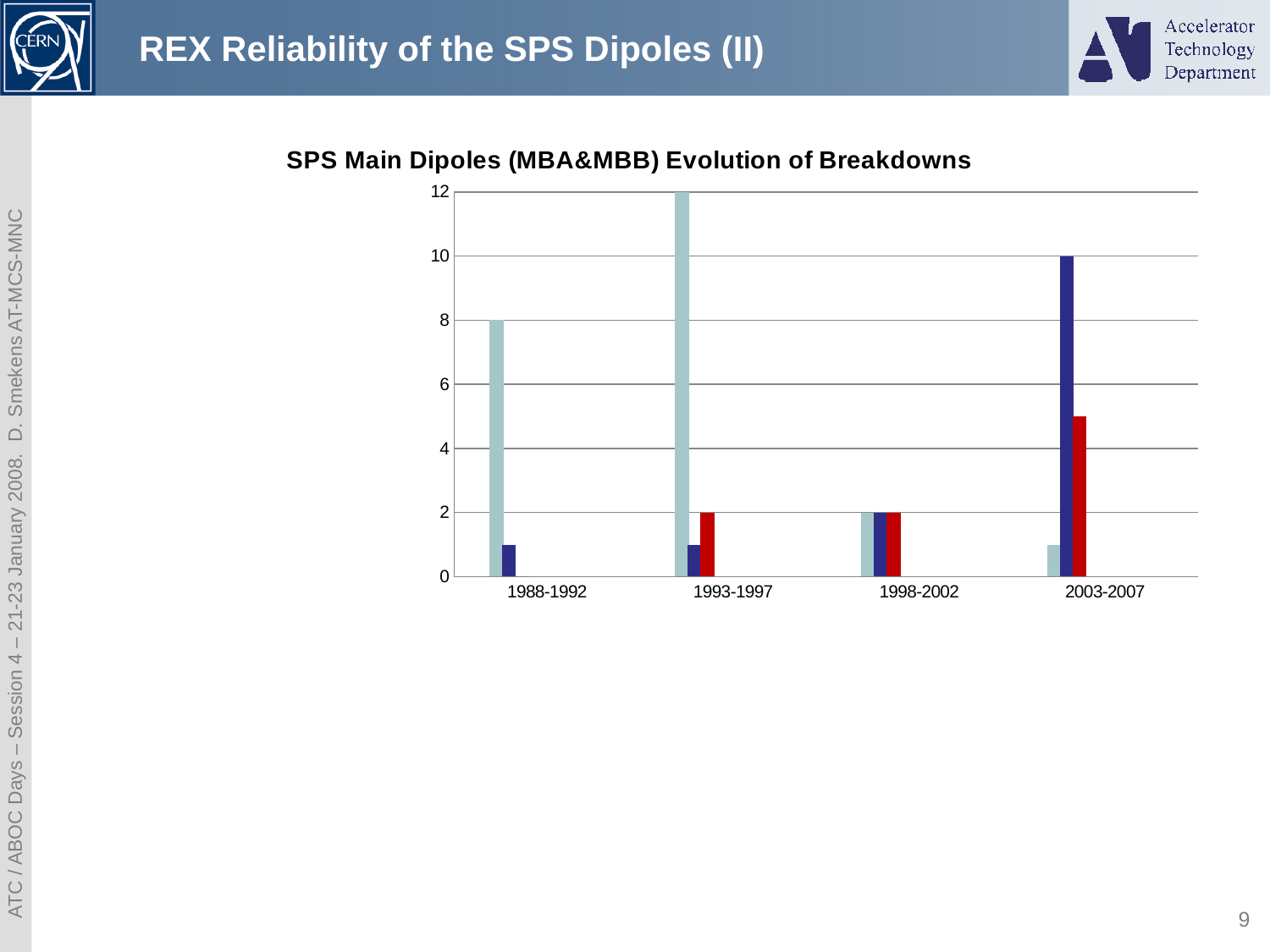
What kind of chart is shown on the slide? bar chart Which period has the highest dark blue bar? 2003-2007 Which period has the highest light blue bar? 1993-1997 How many period categories are shown on the x axis? 4 What is the title of the chart? SPS Main Dipoles (MBA&MBB) Evolution of Breakdowns What is the value of the light blue bar for 1993-1997? 12 Is the red bar for 2003-2007 greater or less than 4? greater Is the light blue bar for 2003-2007 greater or less than 2? less What is the value of the red bar for 1998-2002? 2 What is the value of the light blue bar for 1988-1992? 8 Which is larger for 1993-1997, the light blue bar or the red bar? the light blue bar What is the value of the dark blue bar for 2003-2007? 10